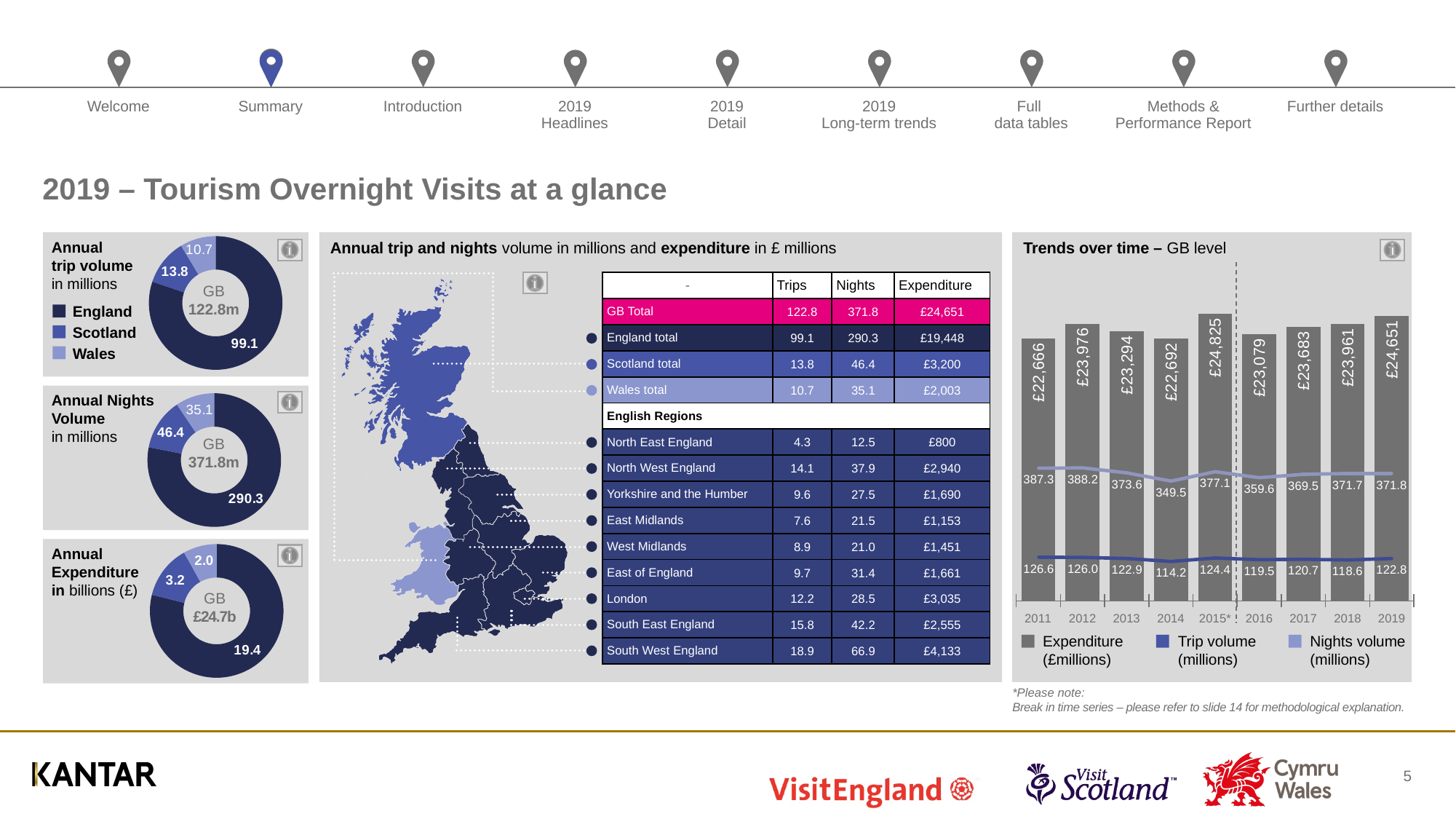
In the Annual trip volume chart, which nation has the largest share? England In the Trends over time chart, what is the nights volume for 2019? 371.8 In the Trends over time chart, what is the expenditure value for 2015*? £24,825 In the Annual Expenditure chart, what is the value for Scotland? 3.2 In the Annual Expenditure chart, which nation has the smallest value? Wales In the Trends over time chart, what is the difference in expenditure between 2019 and 2011? £1,985 In the Annual Nights Volume chart, what is the value for Wales? 35.1 What kind of chart is the Annual trip volume chart? donut chart In the Trends over time chart, which year has the highest expenditure? 2015* How many series does the legend of the Trends over time chart list? 3 In the Annual trip volume chart, what is the value for England? 99.1 In the Trends over time chart, which year has the lowest trip volume? 2014